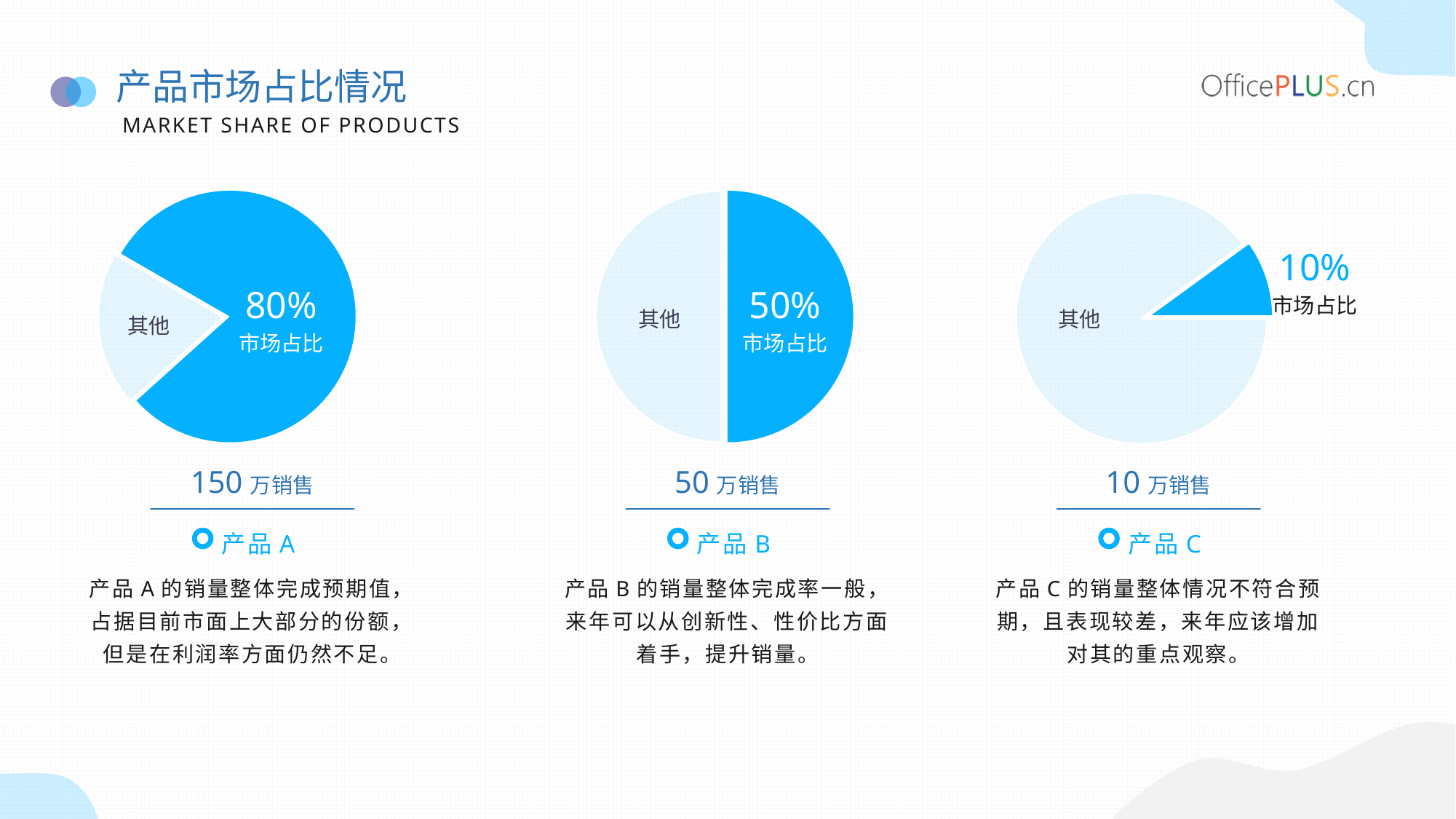
What is the difference in market share between 产品 A and 产品 B? 30% What sales figure is printed below the pie chart for 产品 C? 10 万销售 In the pie chart for 产品 C, what market share (市场占比) is shown for 产品 C? 10% Which has a larger market share, 产品 B or 产品 C? 产品 B In the pie chart for 产品 A, what market share (市场占比) is shown for 产品 A? 80% In the pie chart for 产品 B, what market share (市场占比) is shown for 产品 B? 50% What sales figure is printed below the pie chart for 产品 A? 150 万销售 Across the three pie charts, which product has the lowest market share? 产品 C What kind of chart is used to show each product's market share on this slide? Pie chart In the pie chart for 产品 A, what share of the pie does the 其他 slice represent? 20% What is the difference in market share between 产品 B and 产品 C? 40% Across the three pie charts, which product has the highest market share? 产品 A